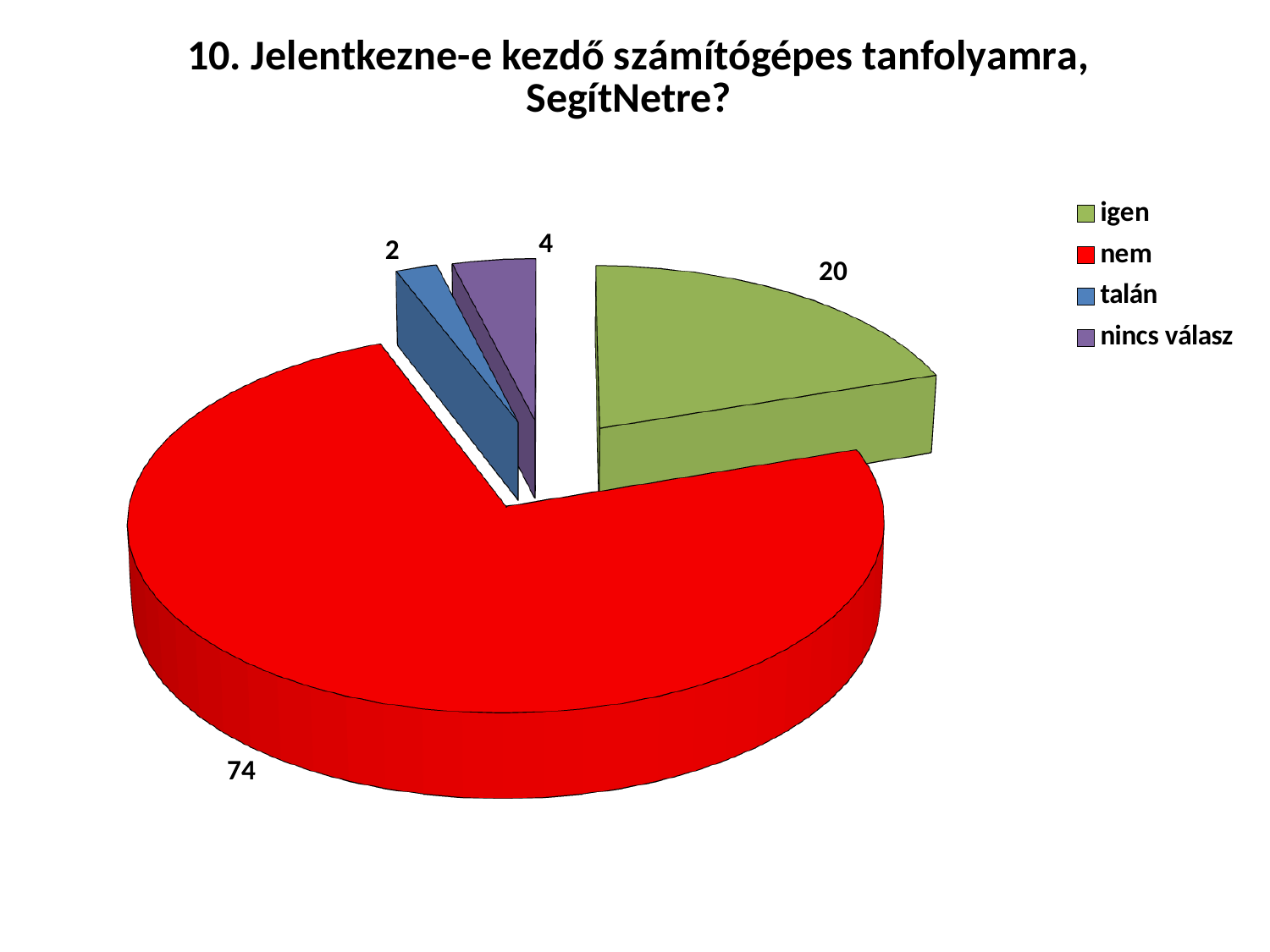
Which is larger, the value for "nincs válasz" or the value for "talán"? nincs válasz Which category has the smallest slice? talán What is the difference between the values for "nem" and "igen"? 54 How many slices does the pie chart have? 4 What is the value for "nincs válasz"? 4 What is the value for "talán"? 2 What is the value for "igen"? 20 What share of the pie does the "igen" slice represent? 20% Which category has the largest slice? nem What colour is the "nem" slice? red What kind of chart is shown on the slide? pie chart What is the value for "nem"? 74